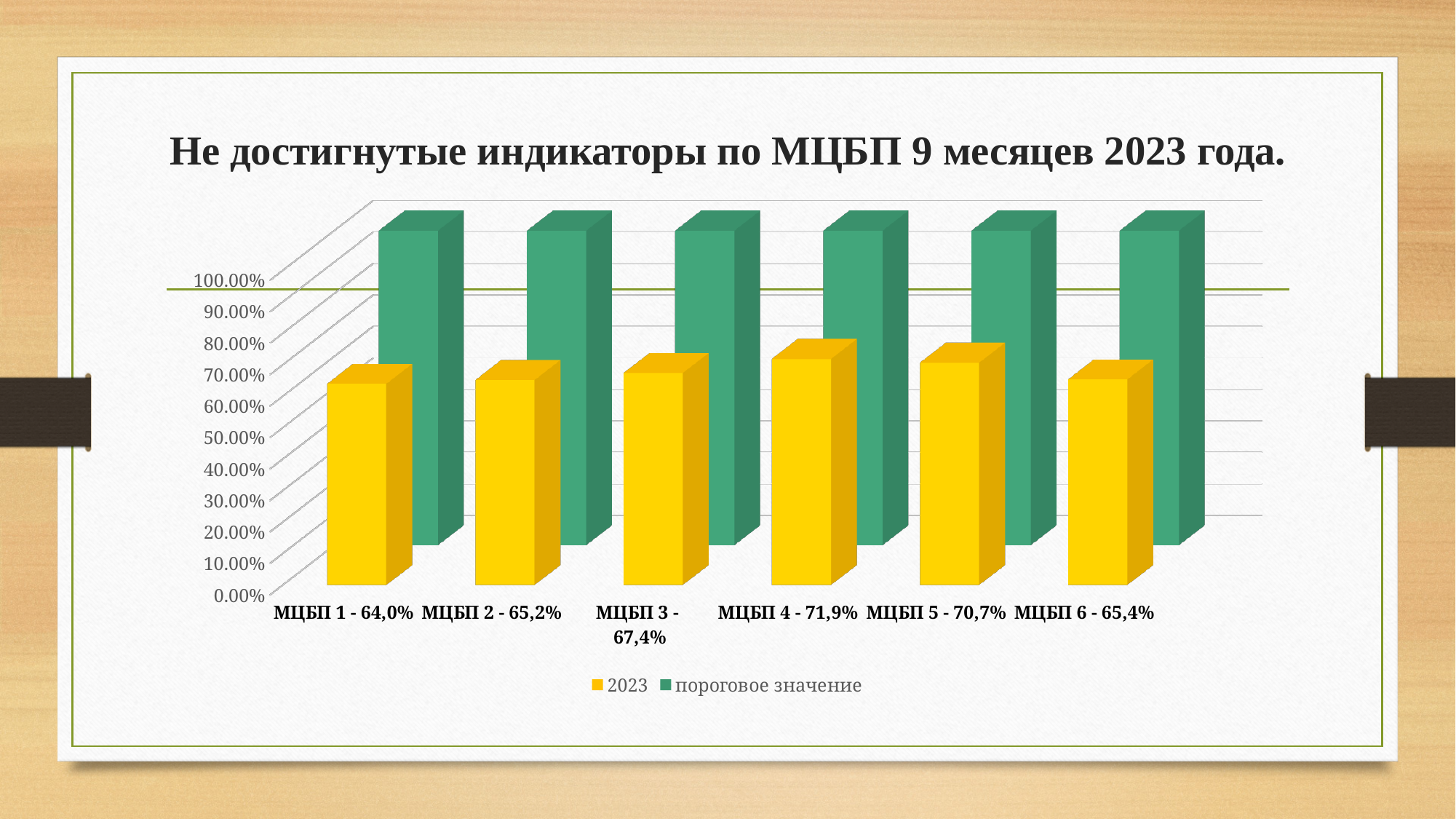
What is the 2023 value for МЦБП 1? 64,0% Which category has the lowest 2023 value? МЦБП 1 How many categories are shown on the x axis? 6 Which category has the highest 2023 value? МЦБП 4 What is the difference between the 2023 values for МЦБП 4 and МЦБП 1? 7,9% What is the 2023 value for МЦБП 6? 65,4% What kind of chart is shown on the slide? bar chart What is the 2023 value for МЦБП 4? 71,9% How many series does the legend list? 2 Which colour represents the 2023 series in the legend? yellow Which has the larger 2023 value, МЦБП 5 or МЦБП 2? МЦБП 5 Is the пороговое значение bar for МЦБП 1 greater or less than 90.00%? greater